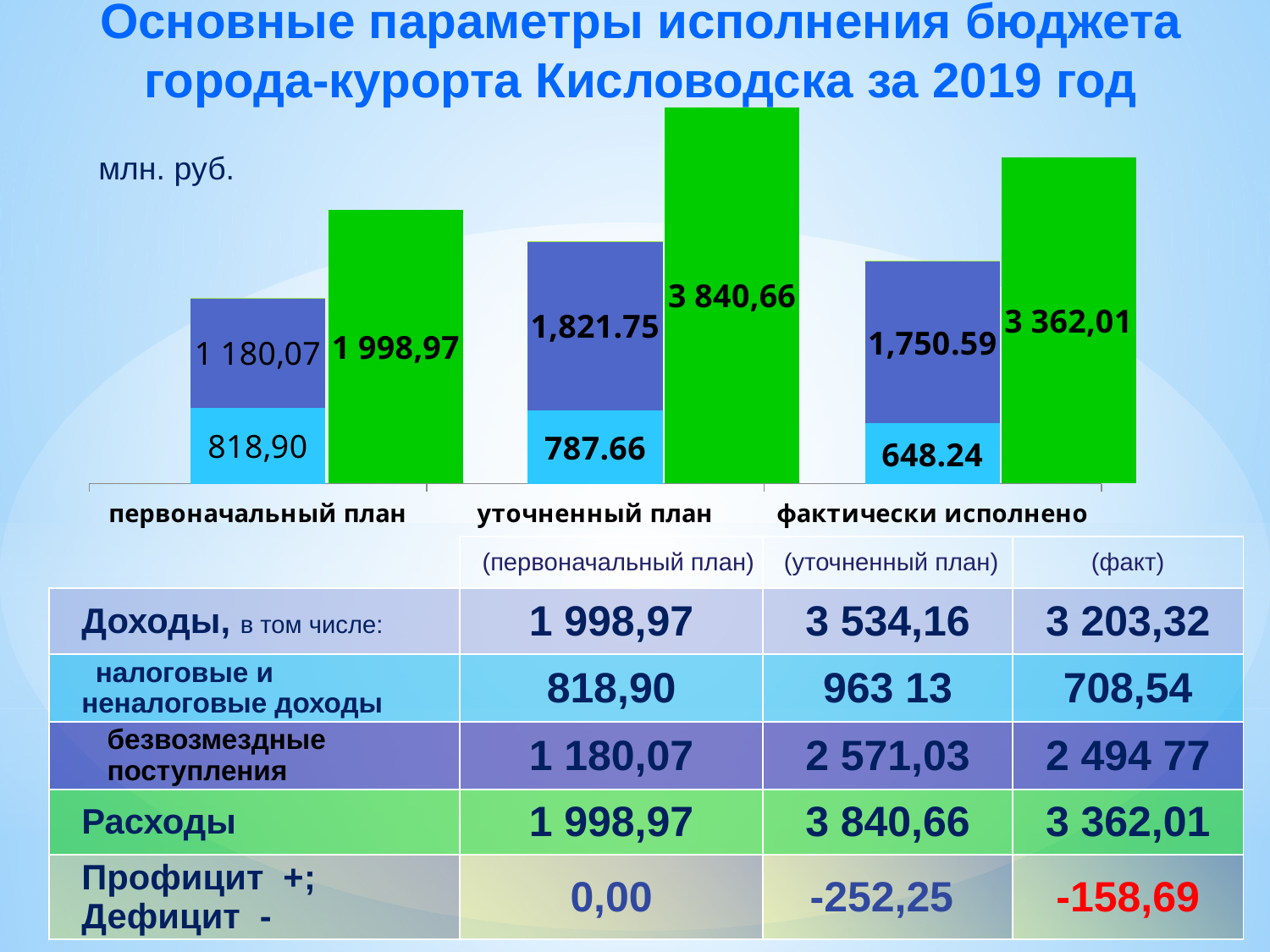
Which green bar is taller: фактически исполнено or первоначальный план? фактически исполнено What is the value printed on the dark blue (top) segment of the stacked bar for первоначальный план? 1 180,07 Do the values of the light blue (bottom) segments rise or fall from первоначальный план to фактически исполнено? fall What is the total of the stacked bar (light blue plus dark blue segments) for первоначальный план? 1 998,97 What is the value printed on the green bar for уточненный план? 3 840,66 What is the value printed on the light blue (bottom) segment of the stacked bar for фактически исполнено? 648.24 What kind of chart is shown on the slide? bar chart What unit label is shown at the top left of the chart? млн. руб. What is the difference between the green bar values for уточненный план and фактически исполнено? 478,65 Which category has the tallest green bar? уточненный план How many categories are shown on the x axis of the chart? 3 Which category has the shortest green bar? первоначальный план